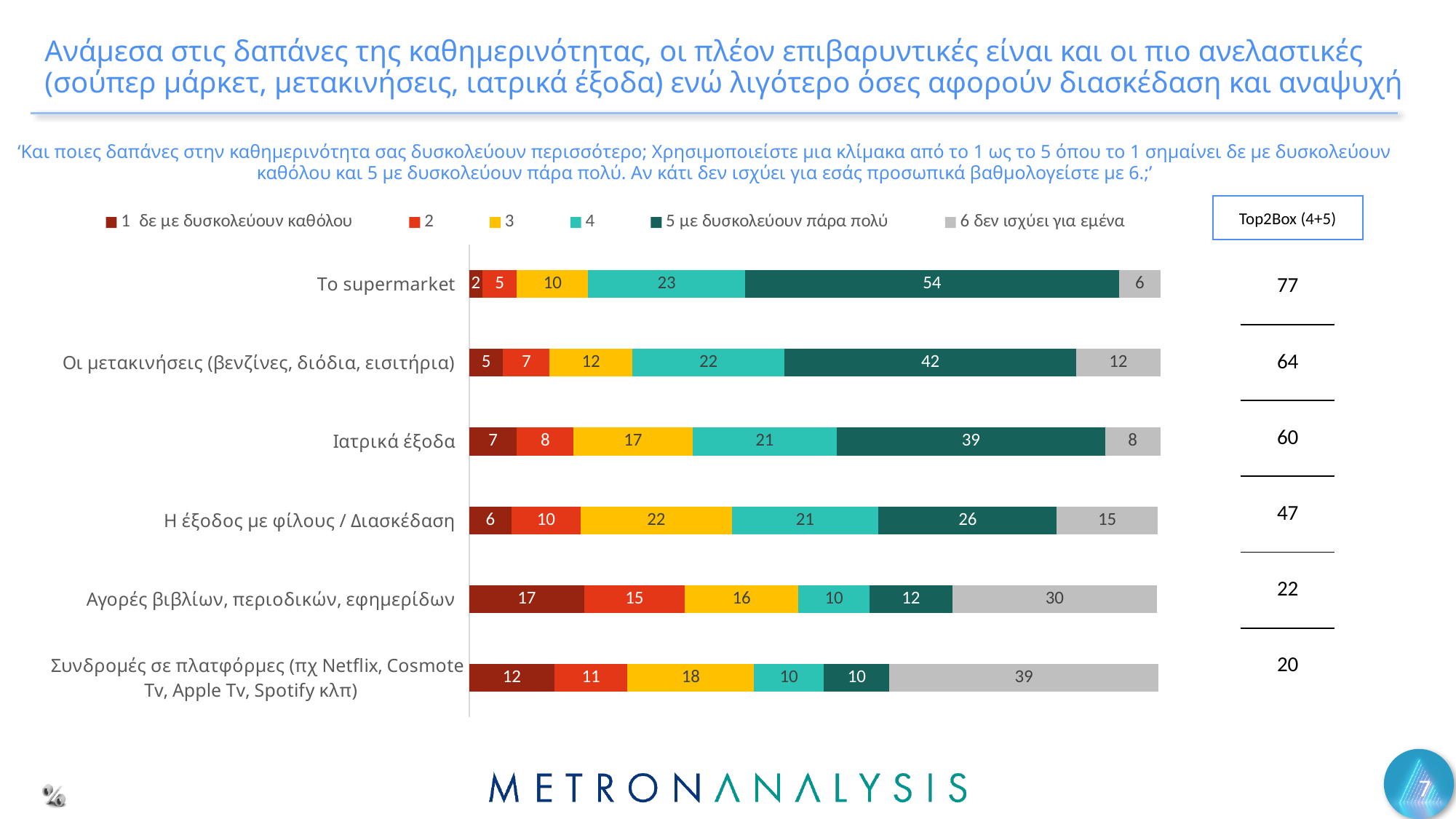
Which category has the lowest Top2Box (4+5) value? Συνδρομές σε πλατφόρμες (πχ Netflix, Cosmote Tv, Apple Tv, Spotify κλπ) How many categories (expense types) are plotted in the chart? 6 What kind of chart is shown on the slide? Stacked bar chart What is the total of the stacked bar for 'Το supermarket'? 100 What is the difference between the Top2Box values of 'Το supermarket' and 'Οι μετακινήσεις (βενζίνες, διόδια, εισιτήρια)'? 13 What is the Top2Box (4+5) value for 'Ιατρικά έξοδα'? 60 What is the value of the '5 με δυσκολεύουν πάρα πολύ' segment for 'Το supermarket'? 54 What is the value of the '6 δεν ισχύει για εμένα' segment for 'Συνδρομές σε πλατφόρμες (πχ Netflix, Cosmote Tv, Apple Tv, Spotify κλπ)'? 39 Which category has the highest '5 με δυσκολεύουν πάρα πολύ' value? Το supermarket Which is larger: the '1 δε με δυσκολεύουν καθόλου' value for 'Αγορές βιβλίων, περιοδικών, εφημερίδων' or for 'Συνδρομές σε πλατφόρμες (πχ Netflix, Cosmote Tv, Apple Tv, Spotify κλπ)'? Αγορές βιβλίων, περιοδικών, εφημερίδων What is the value of the '3' segment for 'Η έξοδος με φίλους / Διασκέδαση'? 22 How many series does the legend list? 6